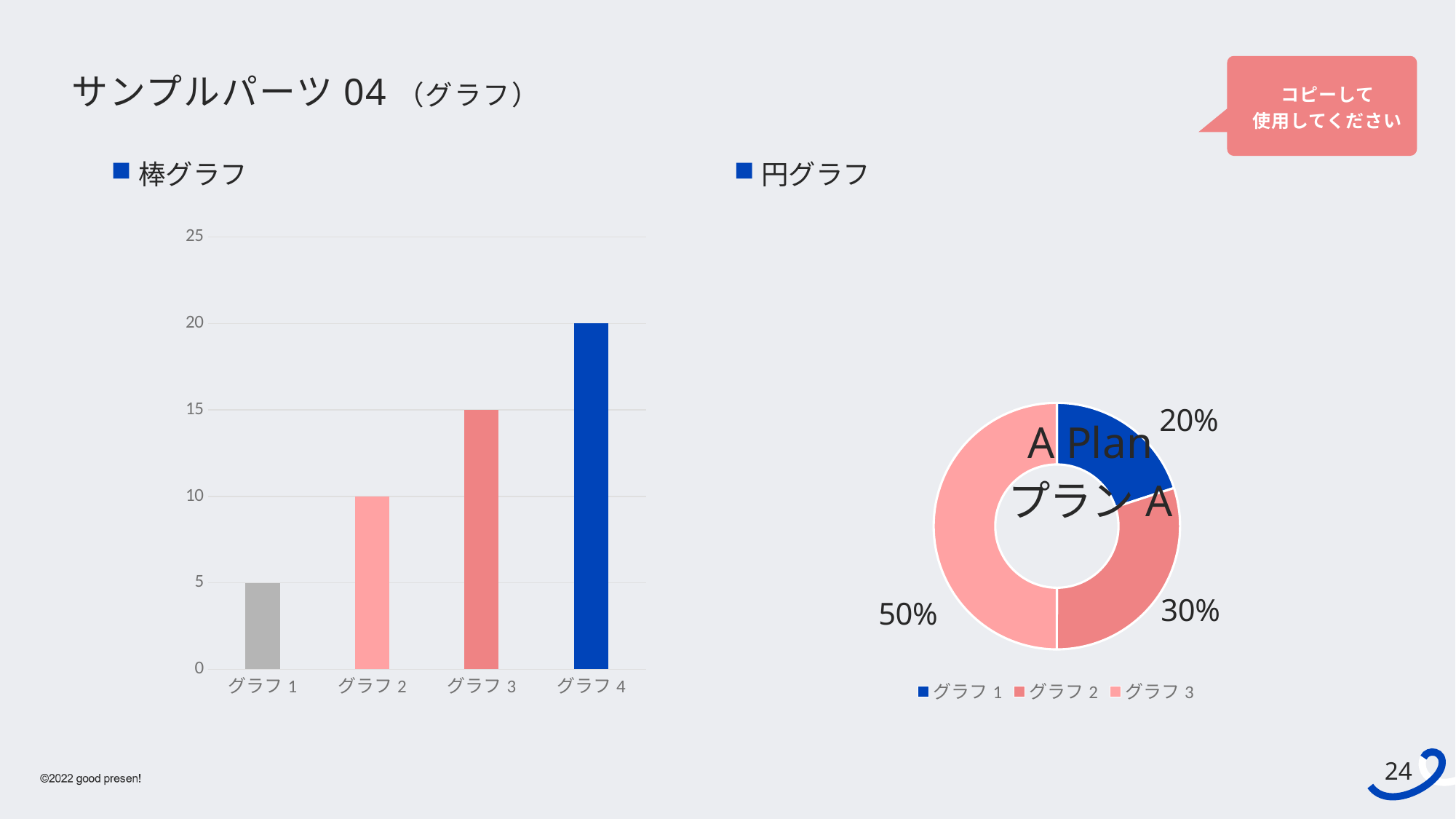
In the bar chart (棒グラフ), which category has the lowest value? グラフ 1 What kind of chart is the chart on the left of the slide? bar chart In the bar chart (棒グラフ), what is the value for グラフ 4? 20 In the pie chart (円グラフ), what share does グラフ 3 have? 50% In the pie chart (円グラフ), how many entries does the legend list? 3 In the pie chart (円グラフ), which of グラフ 1 or グラフ 2 has the larger share? グラフ 2 In the bar chart (棒グラフ), what is the difference between the values for グラフ 3 and グラフ 2? 5 In the bar chart (棒グラフ), how many categories are shown on the x axis? 4 In the bar chart (棒グラフ), what is the value for グラフ 1? 5 In the pie chart (円グラフ), what share does グラフ 1 have? 20% In the bar chart (棒グラフ), which category has the highest value? グラフ 4 In the bar chart (棒グラフ), do the values rise or fall from グラフ 1 to グラフ 4? rise